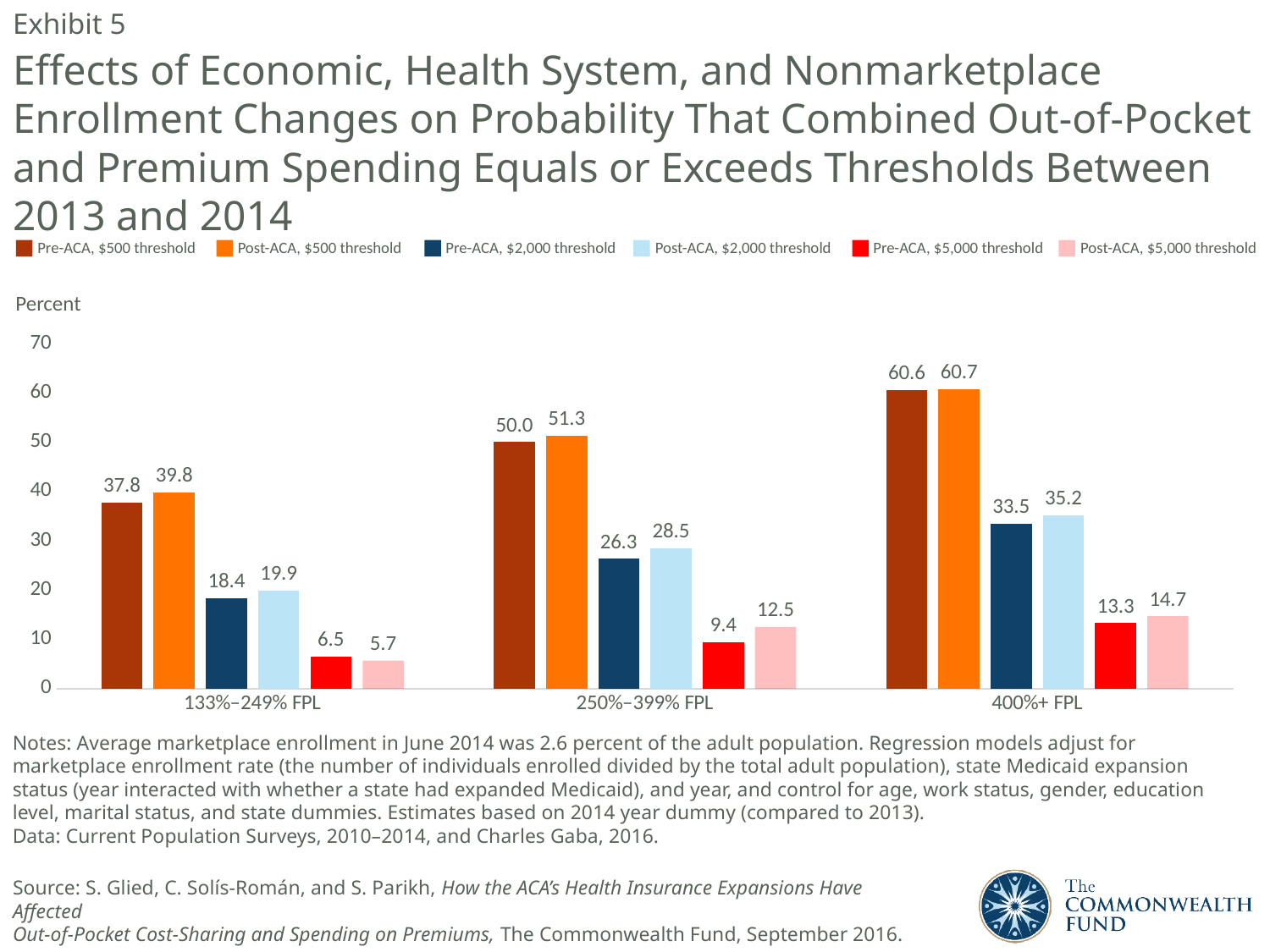
What is the value for Pre-ACA, $5,000 threshold in the 133%–249% FPL group? 6.5 What is the label on the y axis? Percent In the 133%–249% FPL group, which is larger: Pre-ACA, $5,000 threshold or Post-ACA, $5,000 threshold? Pre-ACA, $5,000 threshold How many FPL groups are shown on the x axis? 3 What is the value for Post-ACA, $2,000 threshold in the 400%+ FPL group? 35.2 Which FPL group has the highest value for Pre-ACA, $500 threshold? 400%+ FPL Is the value for Pre-ACA, $2,000 threshold in the 400%+ FPL group greater or less than 30? greater What is the difference between the Post-ACA and Pre-ACA $2,000 threshold values in the 250%–399% FPL group? 2.2 What is the value for Post-ACA, $500 threshold in the 250%–399% FPL group? 51.3 How many series does the legend list? 6 Which FPL group has the lowest value for Post-ACA, $5,000 threshold? 133%–249% FPL What kind of chart is shown on the slide? Bar chart